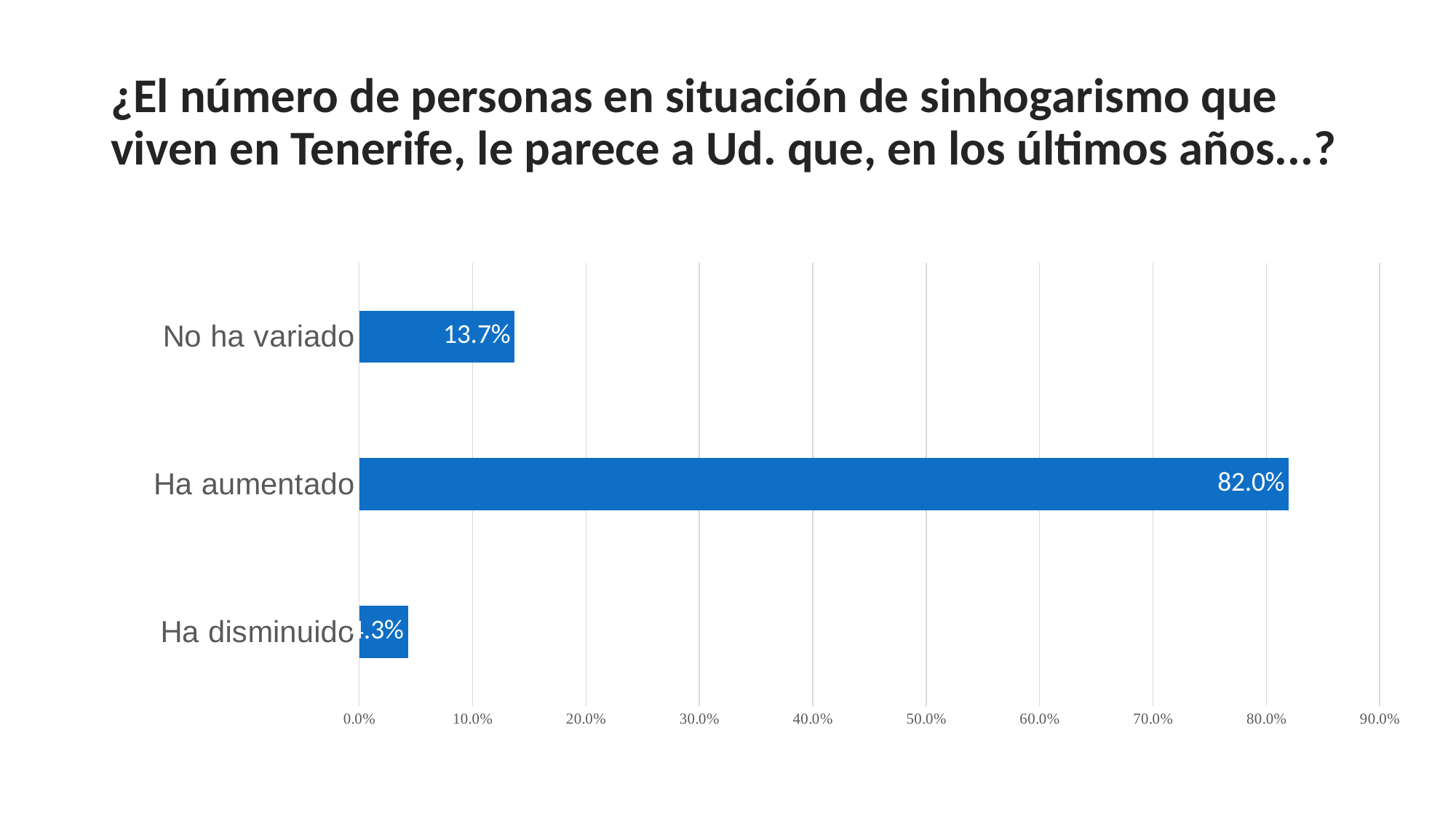
How many categories are shown in the chart? 3 What is the value for "Ha aumentado"? 82.0% What is the difference between the values for "Ha aumentado" and "No ha variado"? 68.3% What colour are the bars in the chart? blue What is the highest value shown on the x axis? 90.0% Is the value for "Ha disminuido" greater or less than 10.0%? less What is the value for "No ha variado"? 13.7% Which category has the lowest value? Ha disminuido Is the value for "Ha aumentado" greater or less than 80.0%? greater Which category has the highest value? Ha aumentado What type of chart is shown on the slide? bar chart Which is larger, the value for "No ha variado" or the value for "Ha disminuido"? No ha variado